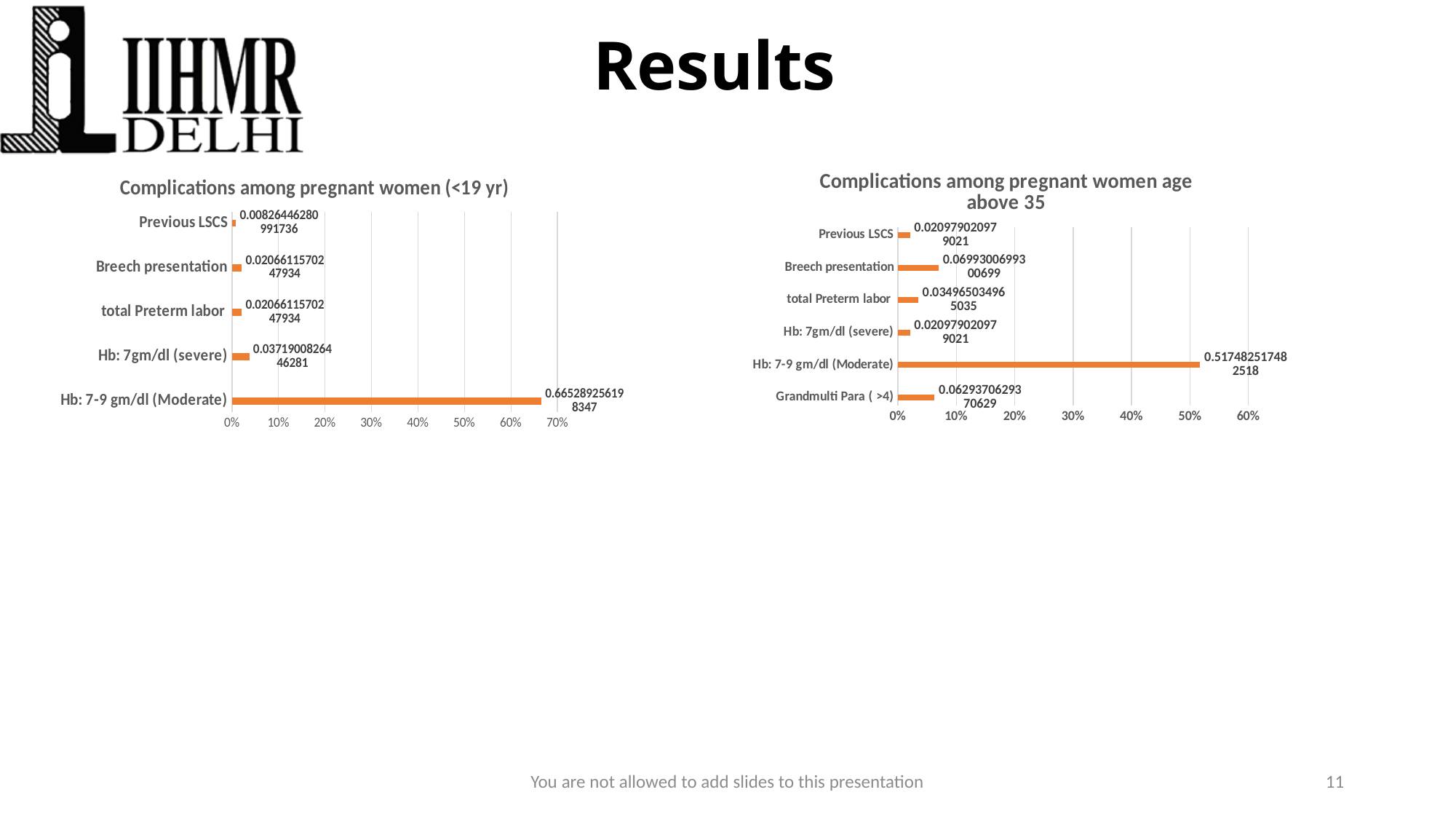
In the chart 'Complications among pregnant women (<19 yr)', what is the value for Hb: 7-9 gm/dl (Moderate)? 0.665289256198347 In the chart 'Complications among pregnant women (<19 yr)', is the value for Hb: 7-9 gm/dl (Moderate) greater or less than 60%? greater In the chart 'Complications among pregnant women age above 35', what is the value for Breech presentation? 0.0699300699300699 What type of chart is 'Complications among pregnant women age above 35'? Bar chart In the chart 'Complications among pregnant women (<19 yr)', which category has the lowest value? Previous LSCS In the chart 'Complications among pregnant women age above 35', which category has the highest value? Hb: 7-9 gm/dl (Moderate) In the chart 'Complications among pregnant women (<19 yr)', what is the value for Hb: 7gm/dl (severe)? 0.0371900826446281 How many categories are shown in the chart 'Complications among pregnant women (<19 yr)'? 5 How many categories are shown in the chart 'Complications among pregnant women age above 35'? 6 In the chart 'Complications among pregnant women (<19 yr)', which category has the highest value? Hb: 7-9 gm/dl (Moderate) In the chart 'Complications among pregnant women age above 35', what is the value for Grandmulti Para ( >4)? 0.0629370629370629 In the chart 'Complications among pregnant women age above 35', which is larger: the value for Breech presentation or the value for total Preterm labor? Breech presentation